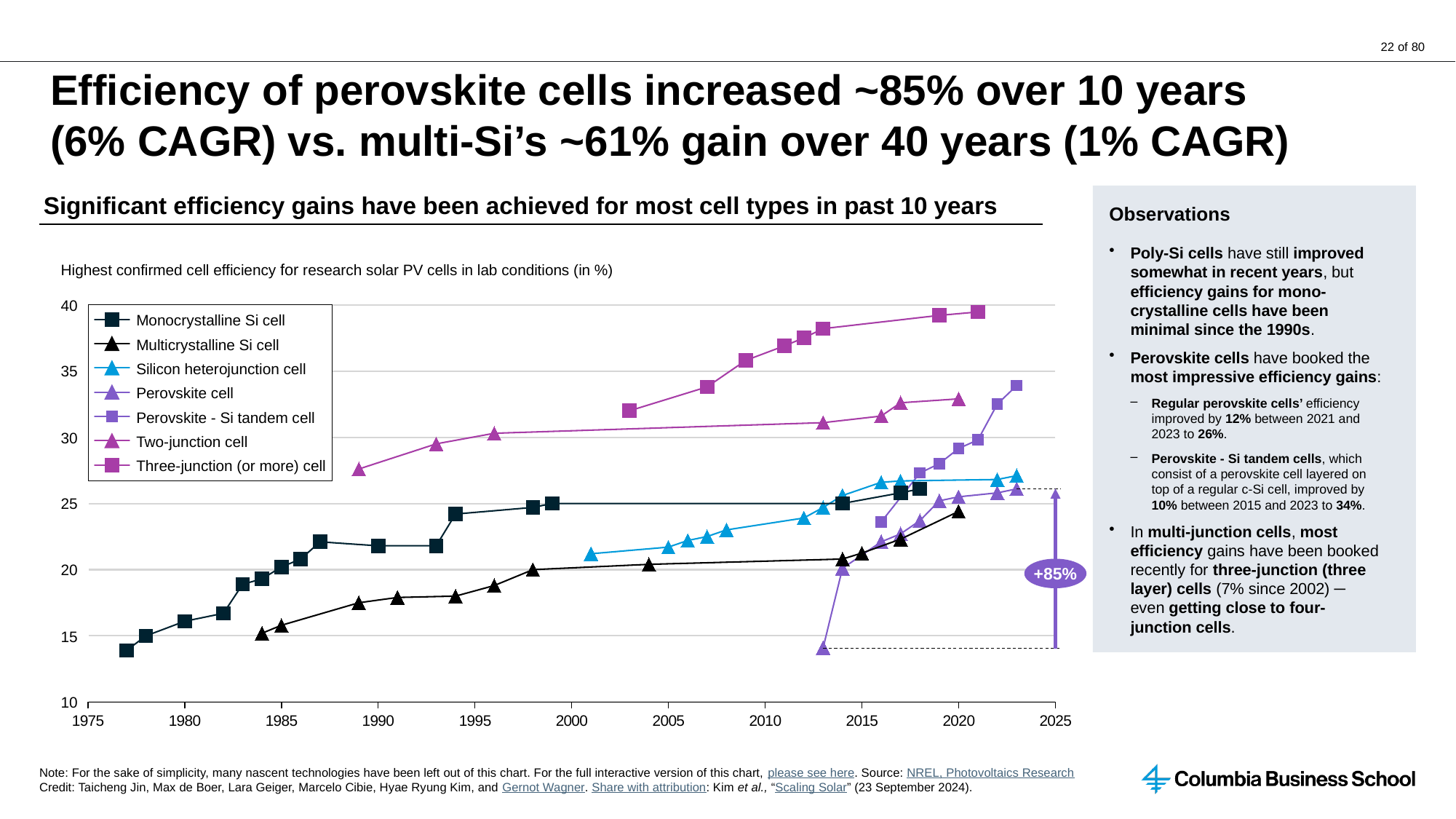
Which series reaches the highest efficiency on the chart? Three-junction (or more) cell What label is shown on the purple arrow annotation at the right of the chart? +85% Is the value for Monocrystalline Si cell in 1977 greater or less than 15? less Is the value for Perovskite cell in 2013 greater or less than 15? less What kind of chart is shown on the slide? line chart What is the subtitle describing the quantity plotted on the chart? Highest confirmed cell efficiency for research solar PV cells in lab conditions (in %) Around 2020, which is higher: Two-junction cell or Silicon heterojunction cell? Two-junction cell Is the value for Multicrystalline Si cell in 1984 greater or less than 20? less In 2023, which is higher: Perovskite - Si tandem cell or Perovskite cell? Perovskite - Si tandem cell How many series does the legend list? 7 Do the values for Perovskite cell rise or fall over time? rise